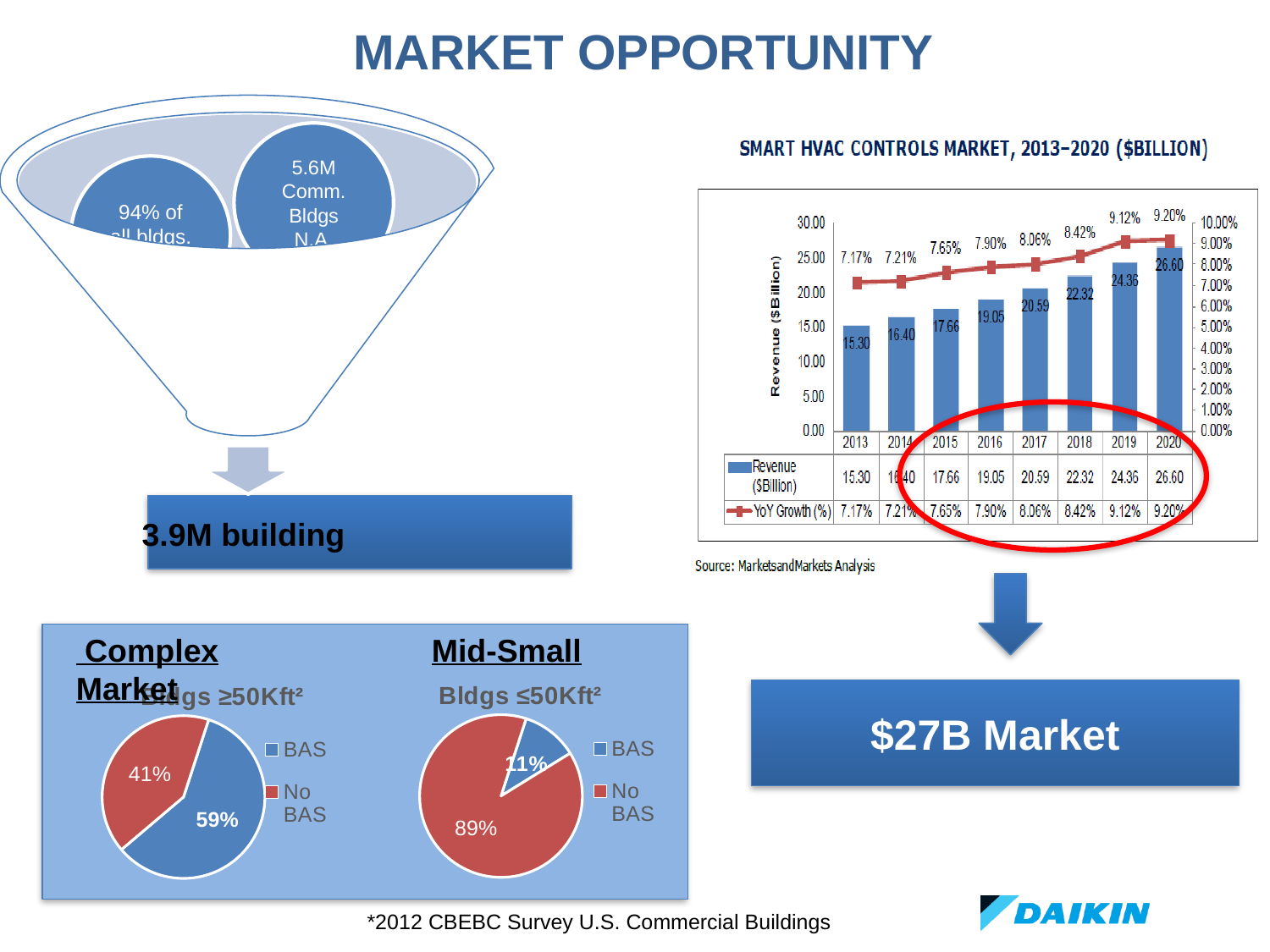
In the Complex Market (Bldgs ≥50Kft²) pie chart, what share is BAS? 59% In the Smart HVAC Controls Market chart, is the revenue for 2018 greater or less than 20.00? greater In the Smart HVAC Controls Market chart, what is the YoY Growth (%) for 2017? 8.06% In the Mid-Small (Bldgs ≤50Kft²) pie chart, which slice is larger, BAS or No BAS? No BAS In the Smart HVAC Controls Market chart, what is the revenue ($Billion) for 2020? 26.60 In the Smart HVAC Controls Market chart, how many years are shown on the x axis? 8 In the Smart HVAC Controls Market chart, which year has the lowest revenue? 2013 In the Smart HVAC Controls Market chart, does revenue rise or fall from 2013 to 2020? rise In the Smart HVAC Controls Market chart, how many series does the legend list? 2 What kind of chart is used for the Complex Market Bldgs ≥50Kft² data? pie chart In the Smart HVAC Controls Market chart, what is the difference in revenue ($Billion) between 2020 and 2013? 11.30 In the Mid-Small (Bldgs ≤50Kft²) pie chart, what share is No BAS? 89%